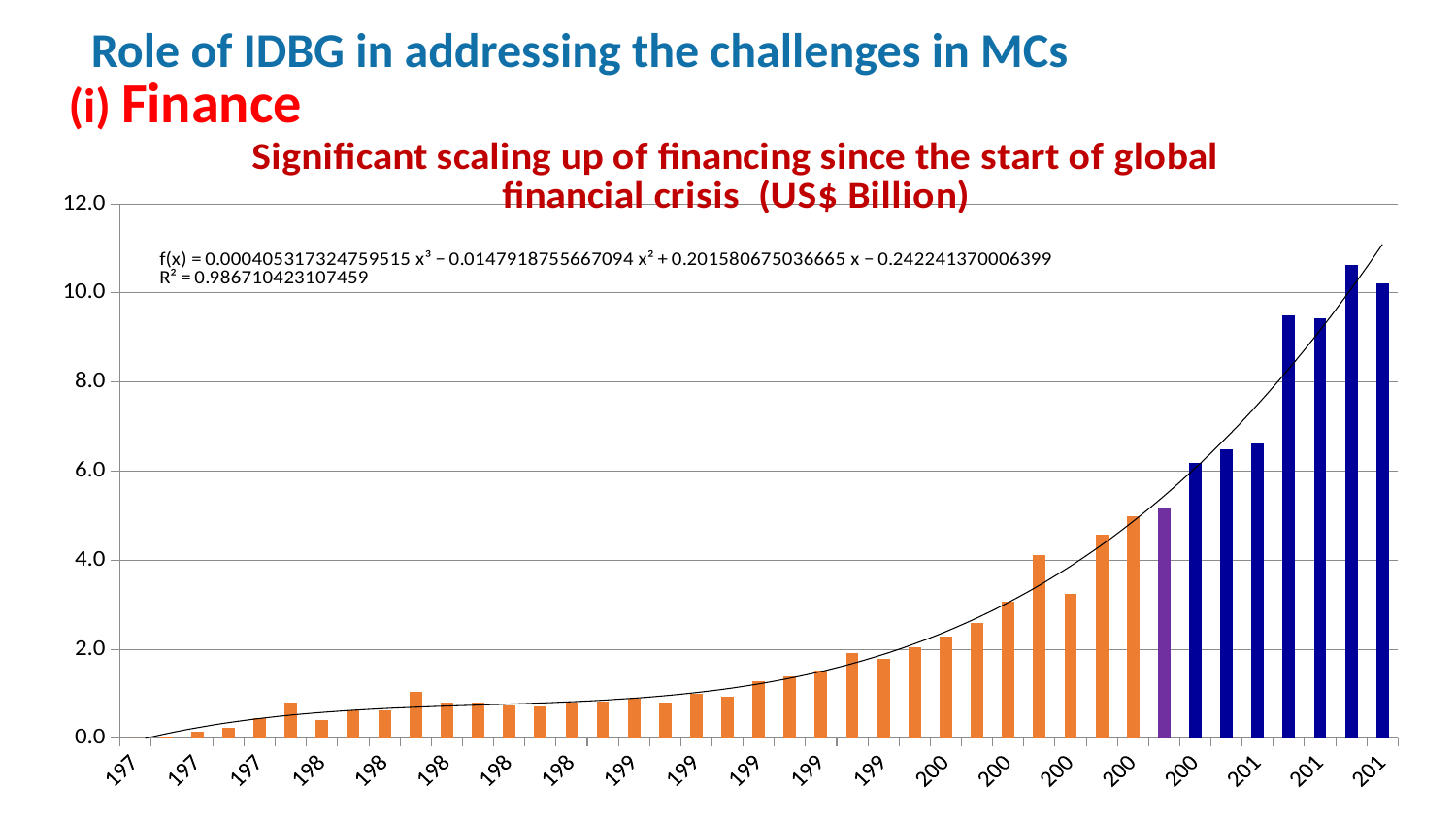
Is the value of the tallest bar greater or less than 10.0? greater What colour are the bars at the right-hand end of the chart? dark blue Which is taller, the purple bar or the first dark blue bar immediately to its right? the first dark blue bar Is the value of the purple bar greater or less than 4.0? greater Do the bar values generally rise or fall from left to right along the x axis? rise What kind of chart is shown on the slide? bar chart Is the value of the purple bar greater or less than 6.0? less What R² value is printed on the chart for the fitted trend line? 0.986710423107459 What is the title of the chart? Significant scaling up of financing since the start of global financial crisis (US$ Billion) Which colour group of bars contains the tallest bar on the chart? dark blue